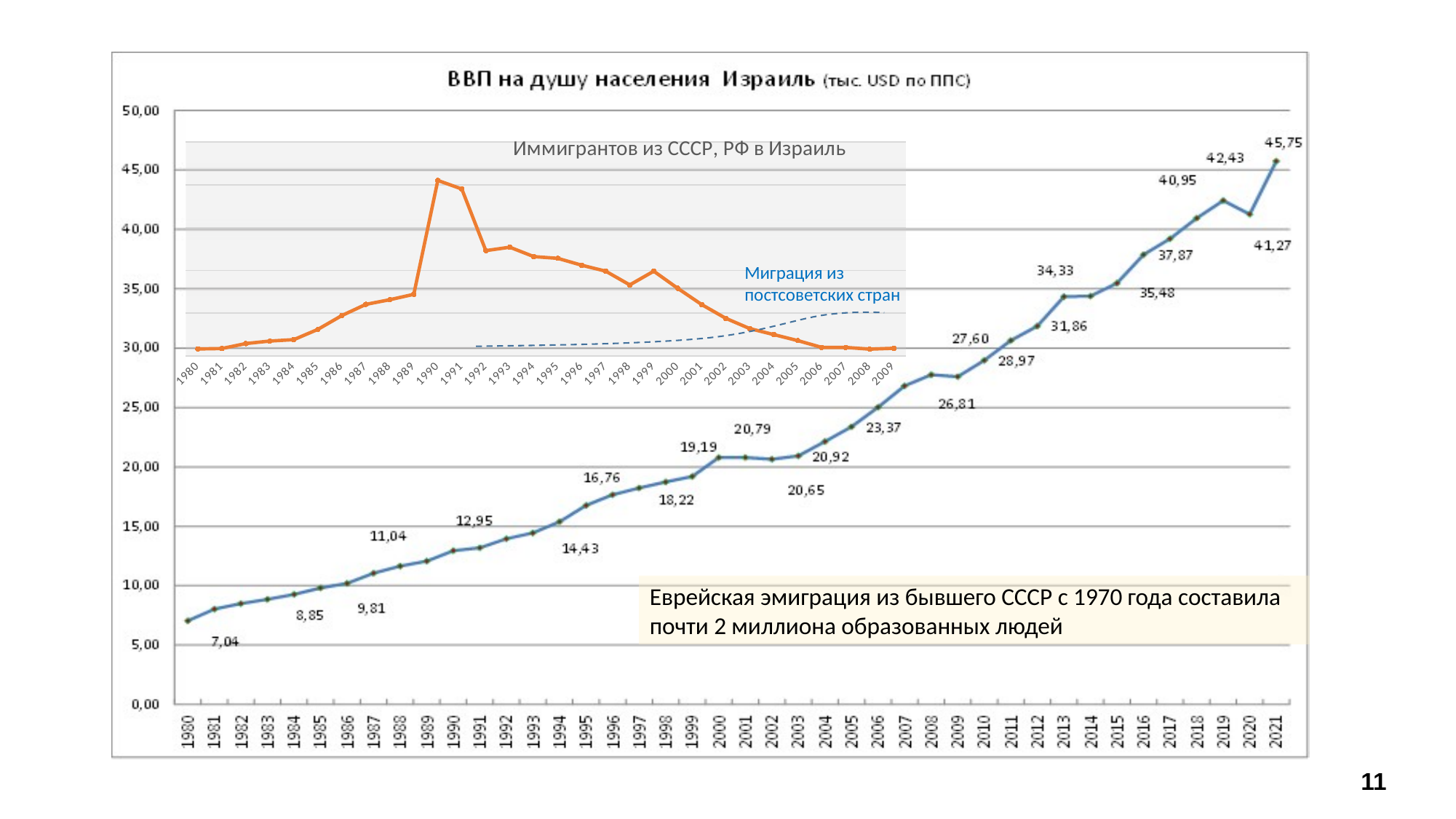
In the main chart "ВВП на душу населения Израиль", what is the value for 2020? 41,27 In the main chart "ВВП на душу населения Израиль", what is the value for 2021? 45,75 In the inset chart "Иммигрантов из СССР, РФ в Израиль", in which year does the orange line reach its peak? 1990 In the main chart "ВВП на душу населения Израиль", what is the value for 2013? 34,33 In the main chart "ВВП на душу населения Израиль", what is the difference between the values for 2021 and 1980? 38,71 In the main chart "ВВП на душу населения Израиль", which year has the lowest value? 1980 In the main chart "ВВП на душу населения Израиль", is the value for 2010 greater or less than 25,00? greater In the main chart "ВВП на душу населения Израиль", which year has the larger value, 2019 or 2020? 2019 In the main chart "ВВП на душу населения Израиль", what is the value for 1980? 7,04 What type of chart is the main chart titled "ВВП на душу населения Израиль"? line chart In the main chart "ВВП на душу населения Израиль", what is the value for 2019? 42,43 In the main chart "ВВП на душу населения Израиль", which year has the highest value? 2021